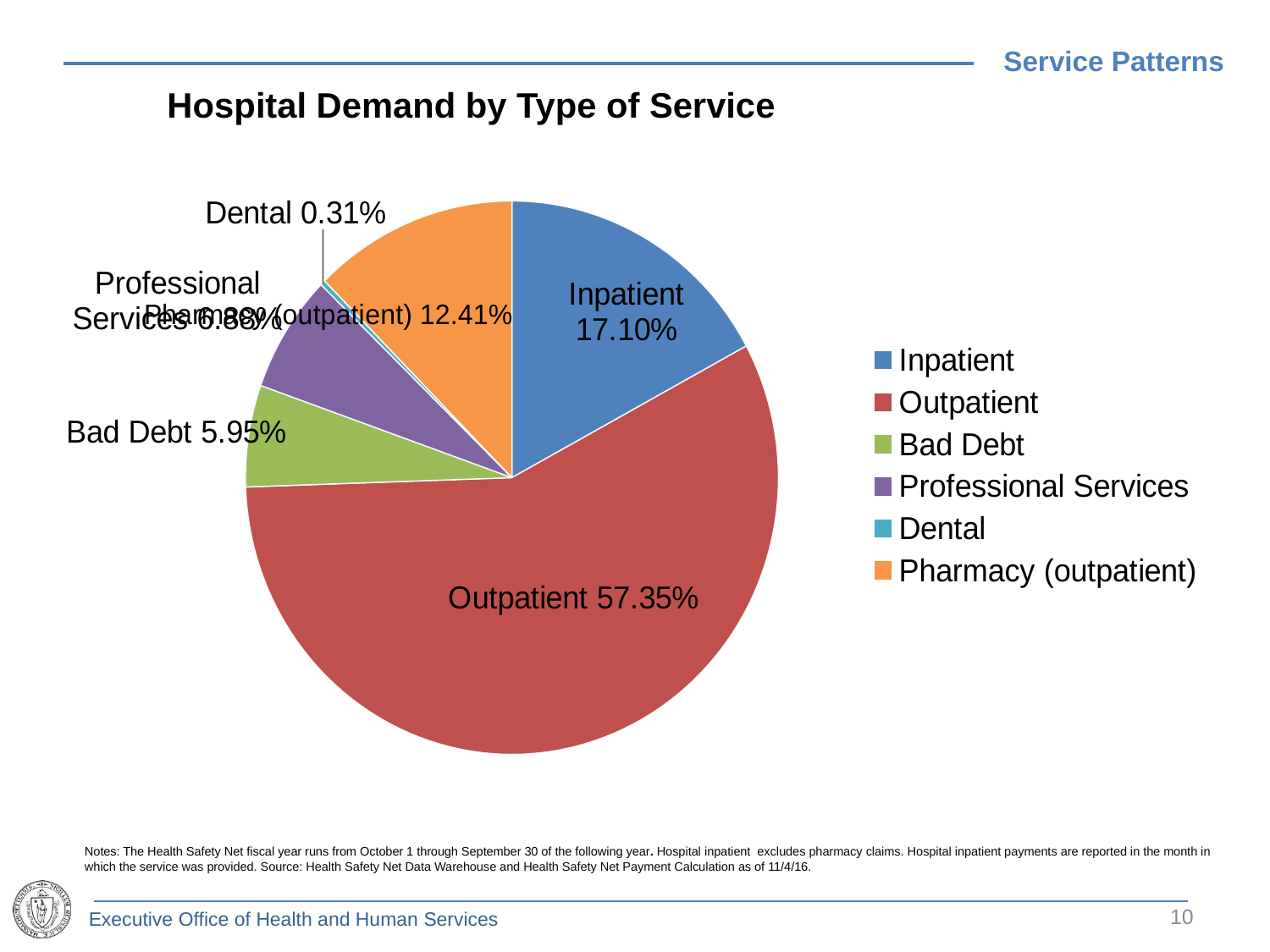
Which type of service has the smallest share of hospital demand? Dental What share of hospital demand is Outpatient? 57.35% How many categories does the legend list? 6 What is the title of the chart? Hospital Demand by Type of Service What kind of chart is shown on the slide? Pie chart What share of hospital demand is Inpatient? 17.10% Which type of service has the largest share of hospital demand? Outpatient Which has a larger share, Inpatient or Pharmacy (outpatient)? Inpatient What share of hospital demand is Pharmacy (outpatient)? 12.41% What share of hospital demand is Bad Debt? 5.95% What share of hospital demand is Dental? 0.31% How many percentage points larger is the Outpatient share than the Inpatient share? 40.25